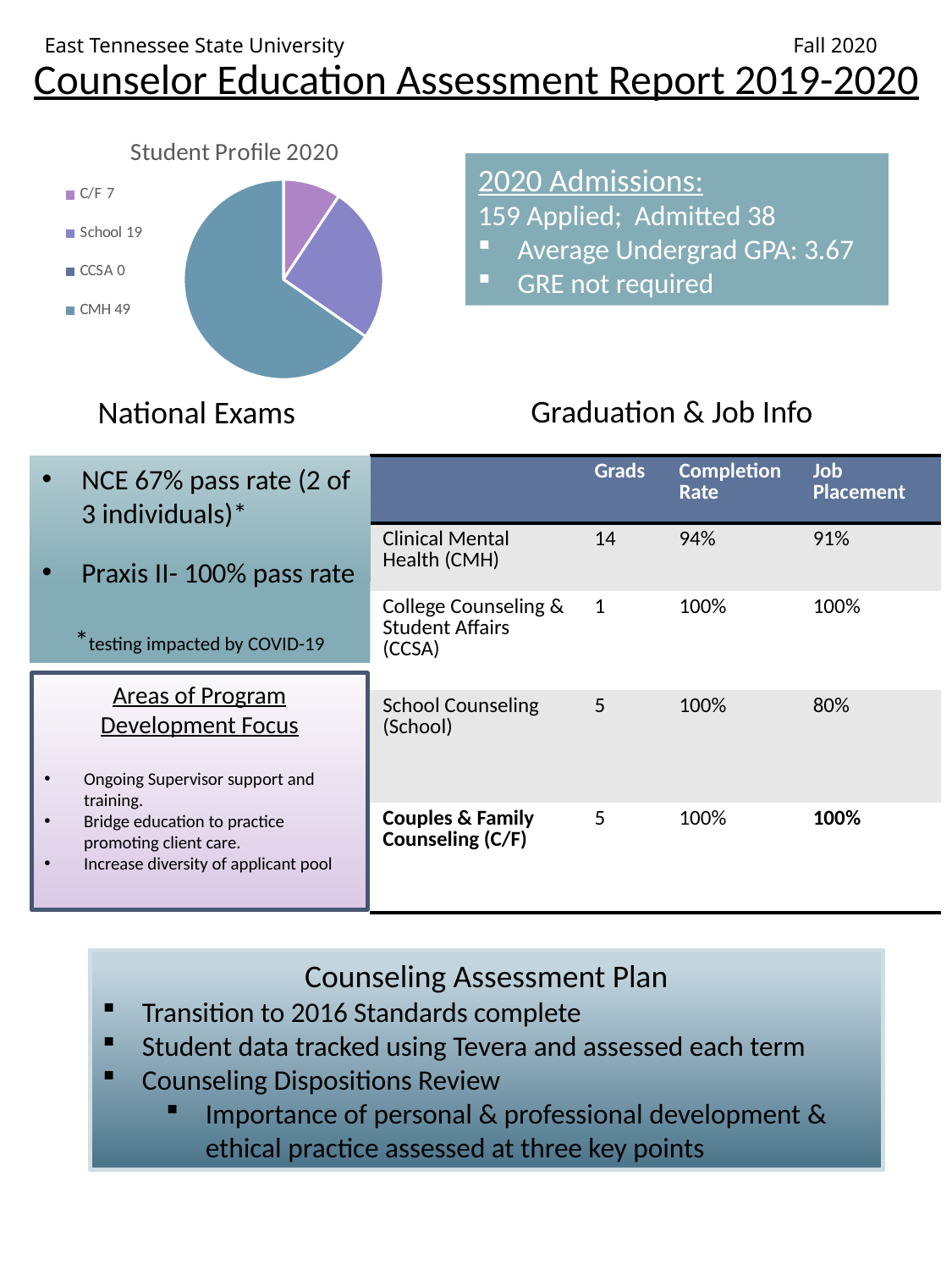
What is the title of the pie chart on the slide? Student Profile 2020 Which category has the smallest value in the Student Profile 2020 pie chart? CCSA What is the total of all the values shown in the Student Profile 2020 pie chart legend? 75 In the Student Profile 2020 pie chart, what is the value for C/F? 7 How many categories are listed in the legend of the Student Profile 2020 pie chart? 4 What kind of chart is the Student Profile 2020 chart? pie chart In the Student Profile 2020 pie chart, what is the value for CMH? 49 In the Student Profile 2020 pie chart, what is the value for CCSA? 0 In the Student Profile 2020 pie chart, which is larger: School or C/F? School Which category has the largest value in the Student Profile 2020 pie chart? CMH In the Student Profile 2020 pie chart, what is the difference between the CMH value and the School value? 30 In the Student Profile 2020 pie chart, what is the value for School? 19